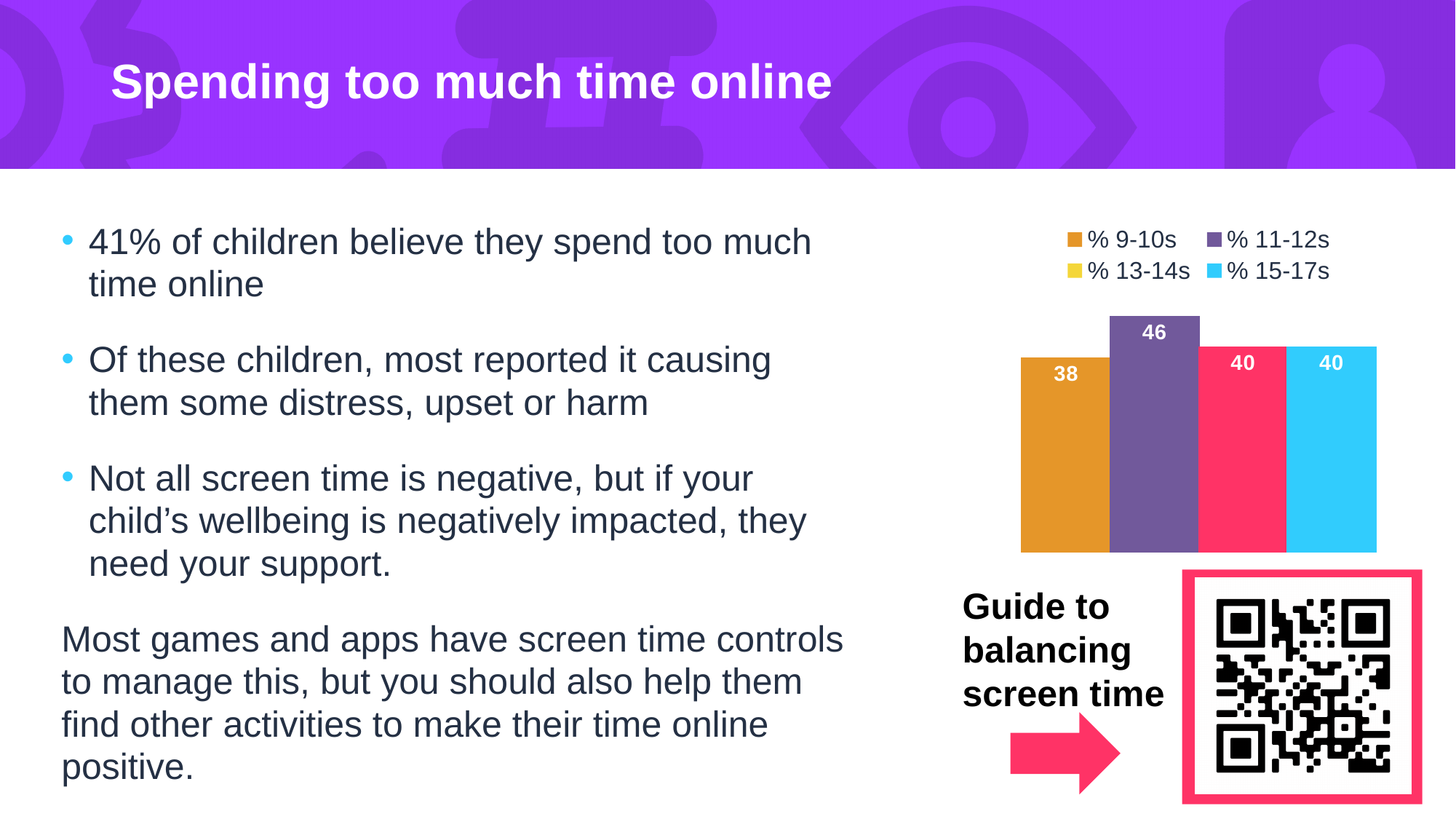
What is the difference between the values for % 13-14s and % 9-10s? 2 Which is larger, the value for % 11-12s or the value for % 15-17s? % 11-12s How many bars are plotted in the chart? 4 What is the value for % 9-10s? 38 What is the value for % 11-12s? 46 What is the value for % 15-17s? 40 What kind of chart is shown on the slide? bar chart How many series does the chart legend list? 4 Which age group has the highest value in the chart? % 11-12s Which legend entry is shown in orange? % 9-10s Which age group has the lowest value in the chart? % 9-10s What is the difference between the values for % 11-12s and % 9-10s? 8